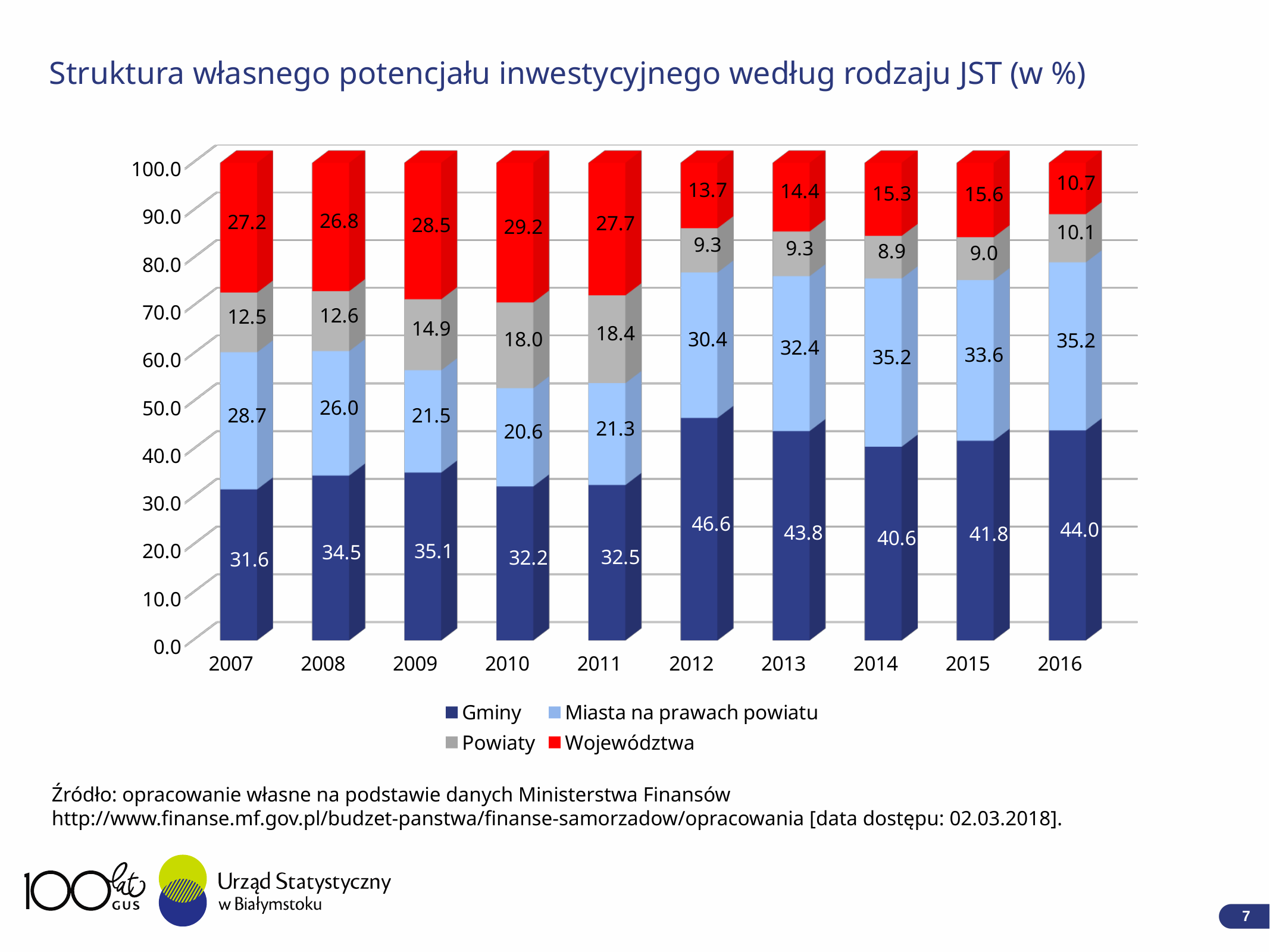
What is the value for Gminy in 2012? 46.6 What is the value for Powiaty in 2016? 10.1 What is the value for Miasta na prawach powiatu in 2009? 21.5 Which is larger in 2011: the value for Gminy or the value for Województwa? Gminy In which year is the Gminy value highest? 2012 In which year is the Powiaty value lowest? 2014 How many series does the legend list? 4 How many years are shown on the x axis? 10 Which colour represents Województwa in the chart? Red What kind of chart is shown on the slide? Stacked bar chart What is the difference between the Województwa values in 2015 and 2016? 4.9 What is the value for Województwa in 2010? 29.2